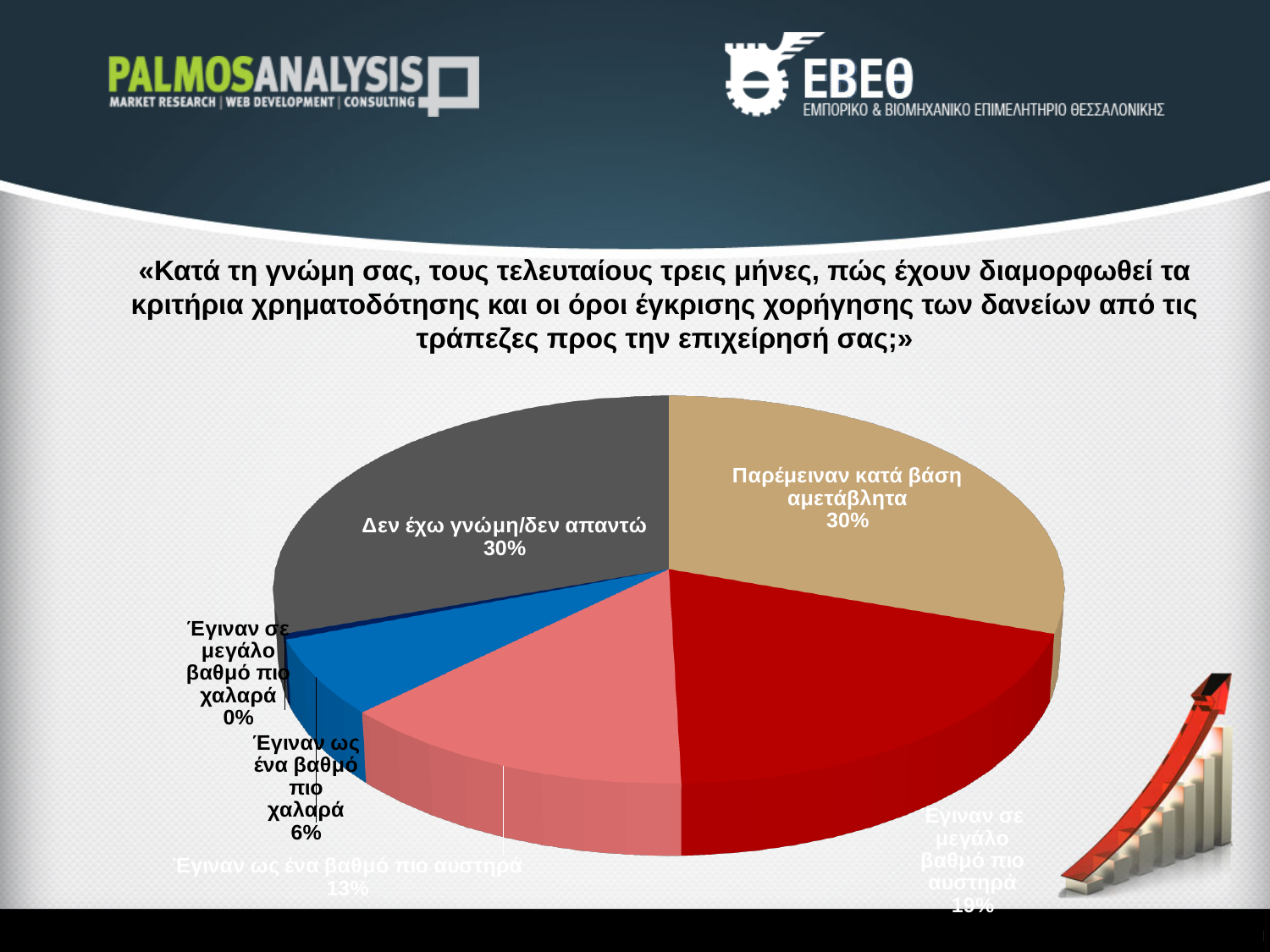
What percentage is shown for "Δεν έχω γνώμη/δεν απαντώ"? 30% What percentage is shown for "Έγιναν ως ένα βαθμό πιο χαλαρά"? 6% What is the difference in percentage points between "Παρέμειναν κατά βάση αμετάβλητα" and "Έγιναν ως ένα βαθμό πιο αυστηρά"? 17 percentage points What kind of chart is shown on the slide? pie chart What is the difference in percentage points between "Έγιναν ως ένα βαθμό πιο αυστηρά" and "Έγιναν ως ένα βαθμό πιο χαλαρά"? 7 percentage points What percentage is shown for "Παρέμειναν κατά βάση αμετάβλητα"? 30% What percentage is shown for "Έγιναν σε μεγάλο βαθμό πιο χαλαρά"? 0% Which is larger: the share for "Έγιναν σε μεγάλο βαθμό πιο αυστηρά" or for "Έγιναν ως ένα βαθμό πιο αυστηρά"? Έγιναν σε μεγάλο βαθμό πιο αυστηρά How many categories (slices) does the pie chart have? 6 Which is larger: the share for "Έγιναν ως ένα βαθμό πιο αυστηρά" or for "Έγιναν ως ένα βαθμό πιο χαλαρά"? Έγιναν ως ένα βαθμό πιο αυστηρά Which category has the smallest share of the pie? Έγιναν σε μεγάλο βαθμό πιο χαλαρά What percentage is shown for "Έγιναν ως ένα βαθμό πιο αυστηρά"? 13%